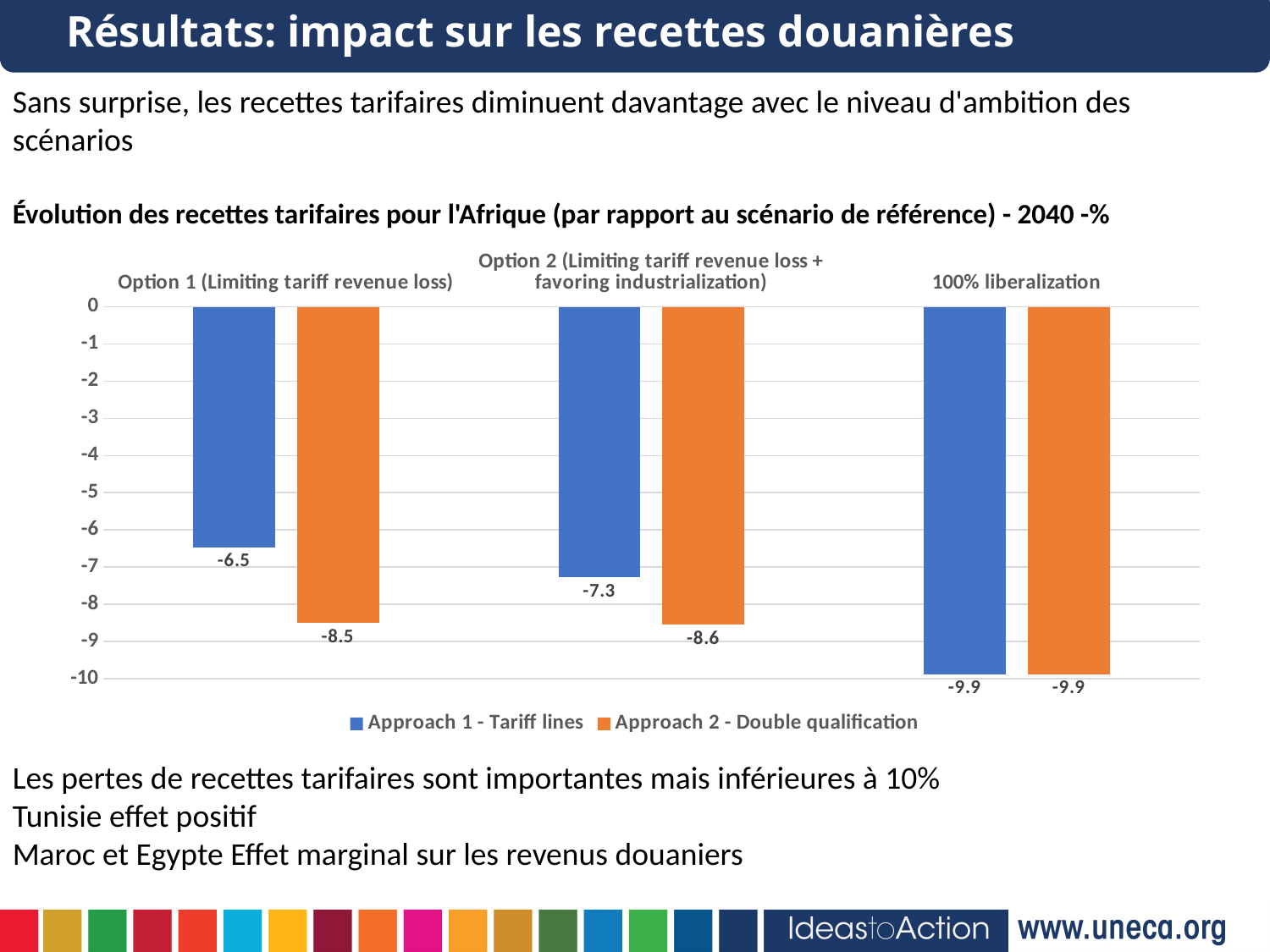
How many series does the chart legend list? 2 Which category has the lowest value for Approach 1 - Tariff lines? 100% liberalization Which colour represents Approach 2 - Double qualification in the chart? Orange Under Option 2, which approach has the larger loss, Approach 1 - Tariff lines or Approach 2 - Double qualification? Approach 2 - Double qualification What is the value for Approach 2 - Double qualification under Option 2 (Limiting tariff revenue loss + favoring industrialization)? -8.6 What is the value for Approach 1 - Tariff lines under 100% liberalization? -9.9 What type of chart is shown on the slide? Bar chart What is the value for Approach 1 - Tariff lines under Option 1 (Limiting tariff revenue loss)? -6.5 What is the difference between the Approach 1 and Approach 2 values under Option 1 (Limiting tariff revenue loss)? 2 What is the value for Approach 2 - Double qualification under Option 1 (Limiting tariff revenue loss)? -8.5 How many categories are shown on the x axis of the chart? 3 Which category has the highest value for Approach 2 - Double qualification? Option 1 (Limiting tariff revenue loss)